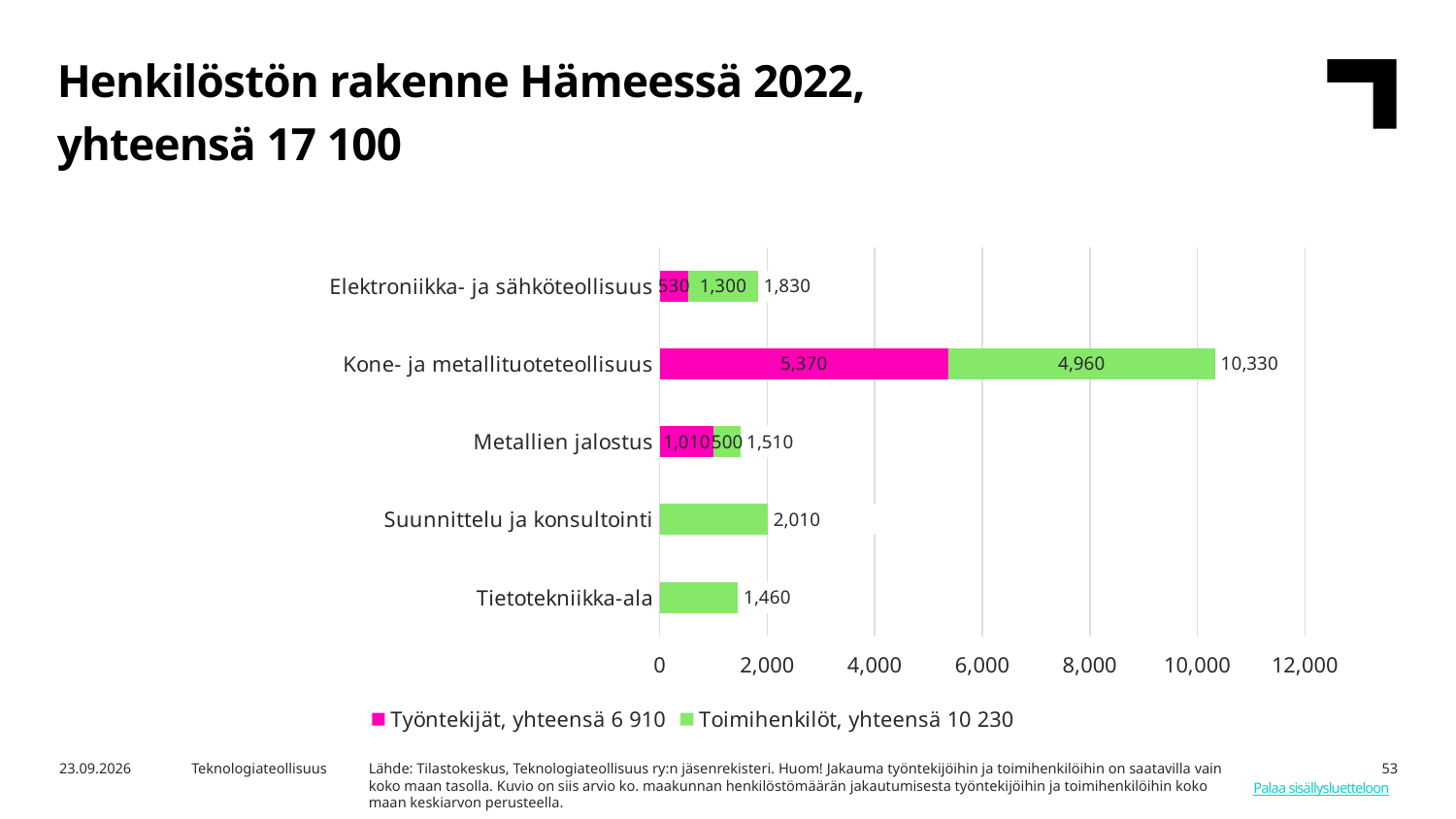
What is the total given in the legend for Toimihenkilöt? 10 230 How many categories are shown in the chart? 5 What is the Toimihenkilöt value for Elektroniikka- ja sähköteollisuus? 1,300 Is the total for Kone- ja metallituoteteollisuus greater or less than 10,000? greater What is the Työntekijät value for Kone- ja metallituoteteollisuus? 5,370 What is the difference between the Työntekijät and Toimihenkilöt values for Kone- ja metallituoteteollisuus? 410 Which is larger: the total for Suunnittelu ja konsultointi or the total for Elektroniikka- ja sähköteollisuus? Suunnittelu ja konsultointi Which category has the lowest total? Tietotekniikka-ala How many series does the legend list? 2 What is the total shown for Metallien jalostus? 1,510 What kind of chart is shown on the slide? Stacked bar chart Which category has the highest total? Kone- ja metallituoteteollisuus